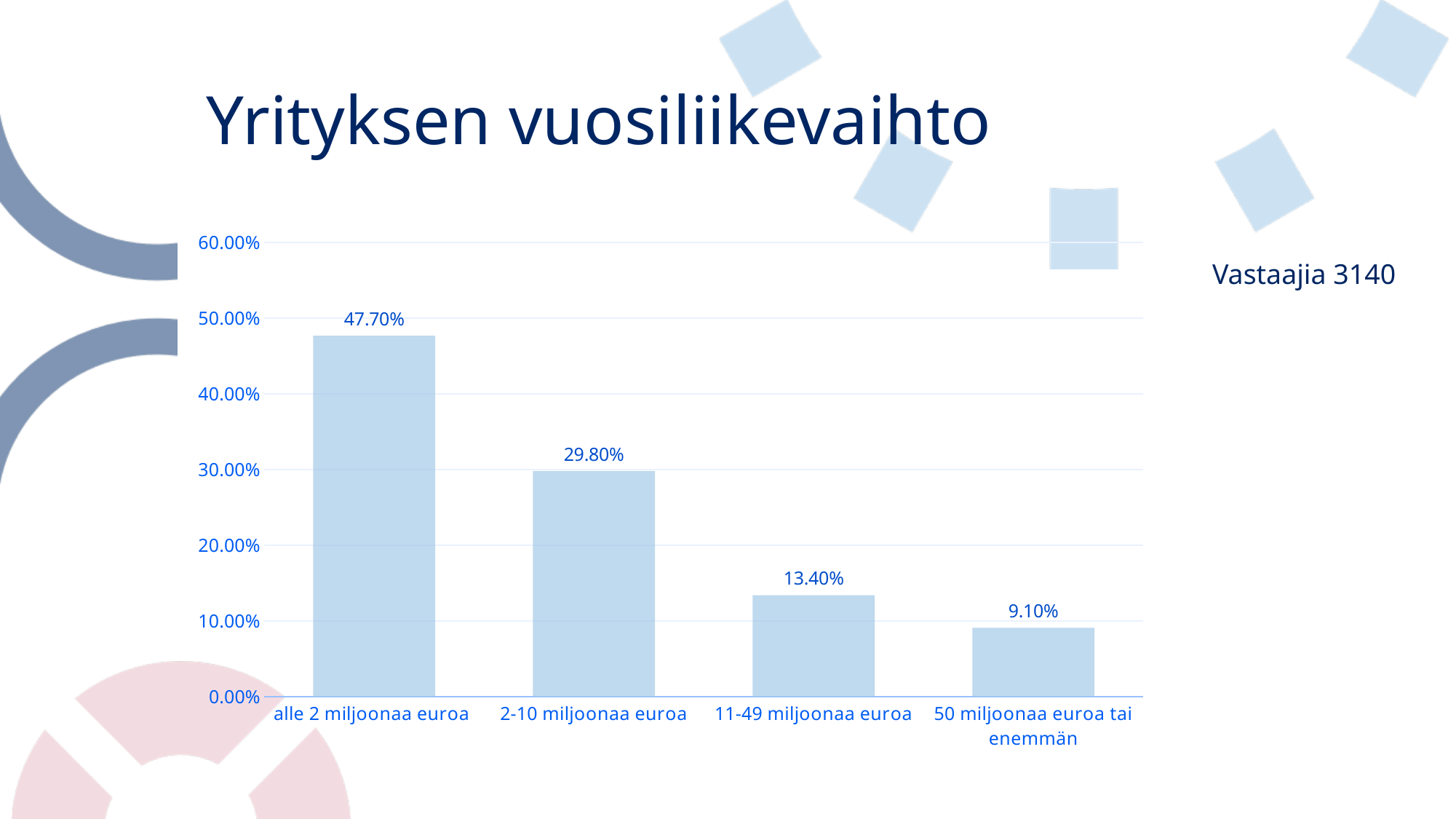
What is the value for '2-10 miljoonaa euroa'? 29.80% What is the value for '11-49 miljoonaa euroa'? 13.40% What is the value for 'alle 2 miljoonaa euroa'? 47.70% Which category has the highest value? alle 2 miljoonaa euroa Is the value for '2-10 miljoonaa euroa' greater or less than 30.00%? less What is the difference between the values for 'alle 2 miljoonaa euroa' and '2-10 miljoonaa euroa'? 17.90% What kind of chart is shown on the slide? bar chart Which is larger, the value for '11-49 miljoonaa euroa' or '50 miljoonaa euroa tai enemmän'? 11-49 miljoonaa euroa Do the values rise or fall from left to right along the x axis? fall What is the value for '50 miljoonaa euroa tai enemmän'? 9.10% How many categories are shown on the x axis? 4 Which category has the lowest value? 50 miljoonaa euroa tai enemmän